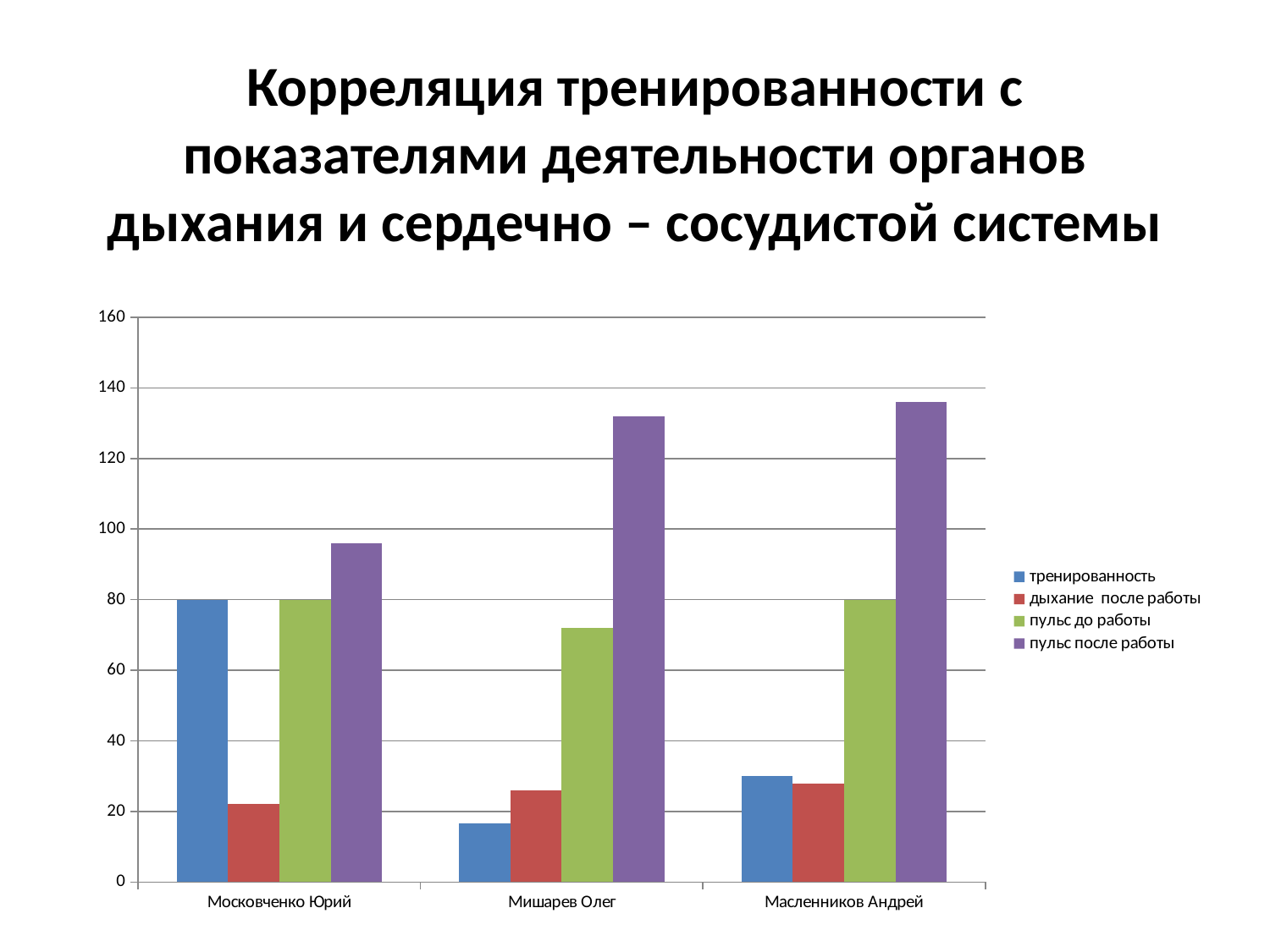
Which is larger: пульс до работы for Мишарев Олег or пульс до работы for Масленников Андрей? Масленников Андрей How many people (categories) are shown on the x axis of the chart? 3 Is the value of тренированность for Мишарев Олег greater or less than 20? less What kind of chart is shown on the slide? bar chart Which person has the lowest value for тренированность? Мишарев Олег Is the value of пульс после работы for Московченко Юрий greater or less than 100? less What is the value of тренированность for Московченко Юрий? 80 Which person has the highest value for тренированность? Московченко Юрий How many series does the chart legend list? 4 Is the value of пульс после работы for Мишарев Олег greater or less than 120? greater What is the value of пульс до работы for Масленников Андрей? 80 Which series is shown in purple in the chart legend? пульс после работы